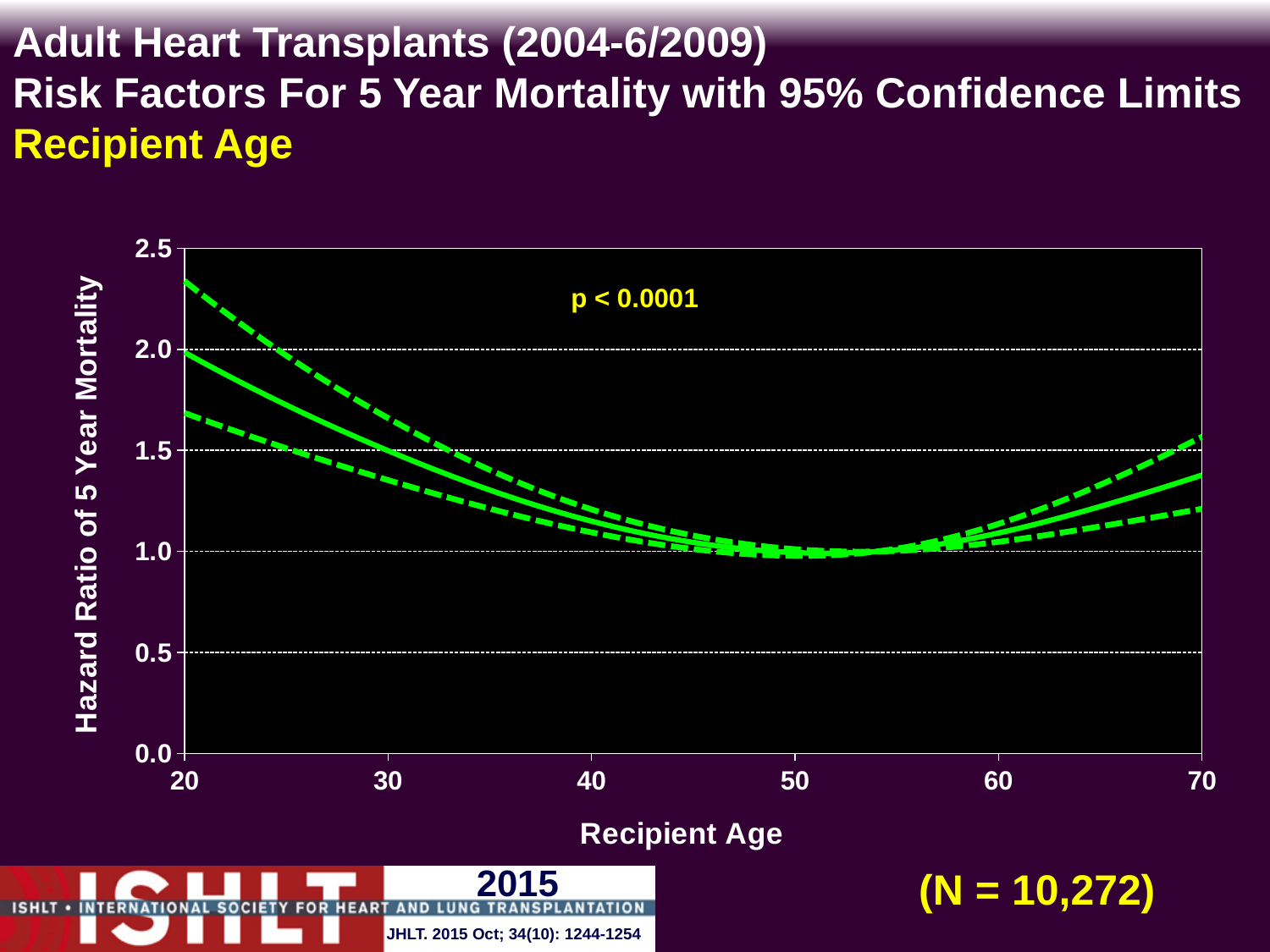
Does the hazard ratio rise or fall as recipient age increases from 50 to 70? rise Is the lower confidence limit (lower dashed line) at recipient age 20 greater or less than 1.5? greater Does the hazard ratio rise or fall as recipient age increases from 20 to 50? fall Which recipient age has the larger hazard ratio on the solid line, 20 or 70? 20 How many lines are plotted on the chart? 3 What is the label of the x axis? Recipient Age Is the hazard ratio (solid line) at recipient age 50 greater or less than 1.5? less Is the upper confidence limit (upper dashed line) at recipient age 20 greater or less than 2.0? greater What p-value is printed on the chart? p < 0.0001 What kind of chart is shown on the slide? line chart